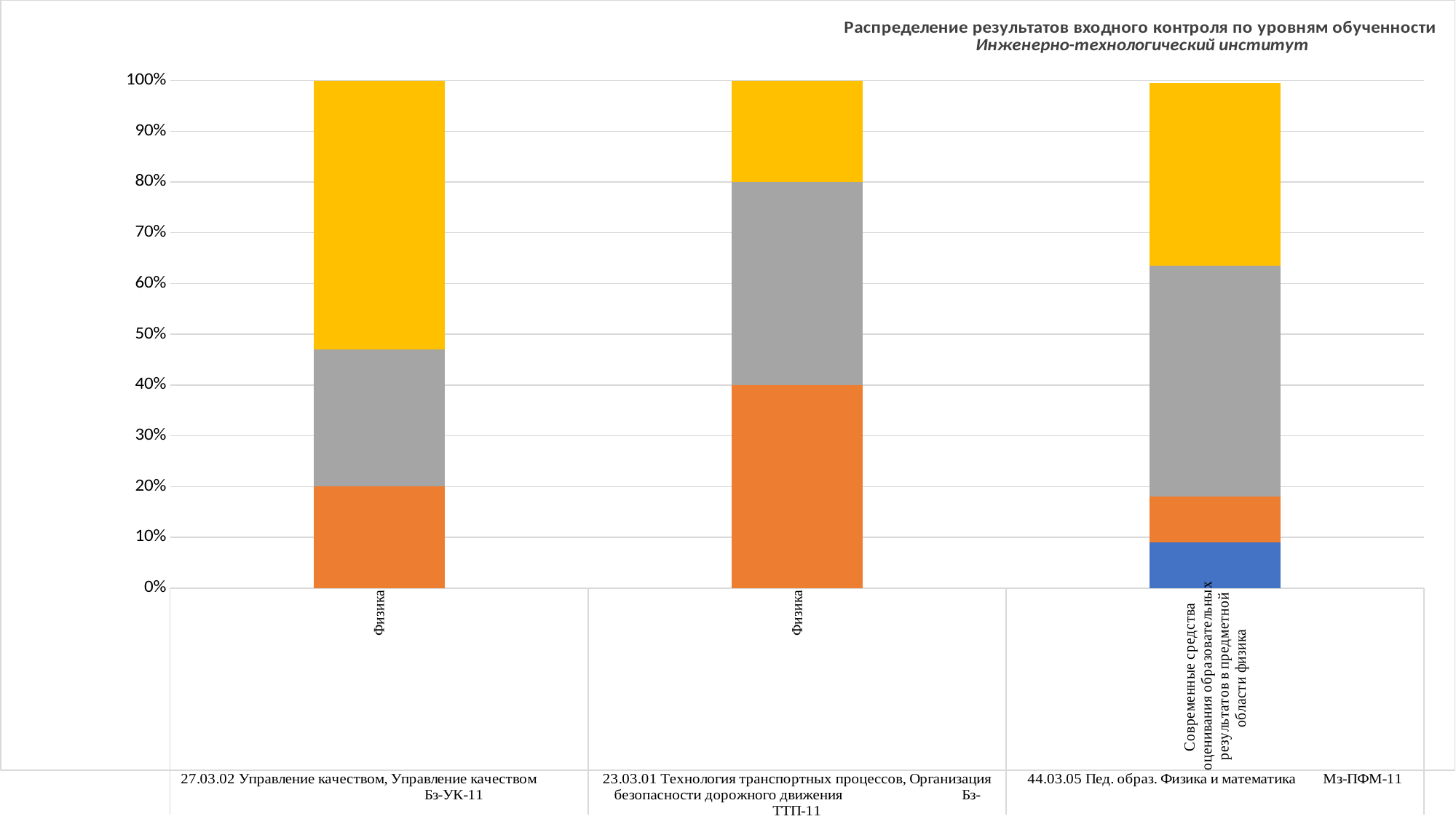
How many bars (groups) are plotted in the chart? 3 What share does the orange segment occupy in the bar for group Бз-УК-11? 20% At what percentage does the top of the gray segment end in the bar for group Бз-ТТП-11? 80% What kind of chart is shown on the slide? Stacked bar chart Is the orange segment larger for group Бз-ТТП-11 or for group Бз-УК-11? Бз-ТТП-11 Which group has the smallest yellow segment? Бз-ТТП-11 Which group has the largest yellow segment? Бз-УК-11 What share does the orange segment occupy in the bar for group Бз-ТТП-11? 40% Is the yellow segment in the bar for group Бз-УК-11 greater or less than 50%? greater Which institute is named in the chart subtitle? Инженерно-технологический институт What is the title of the chart? Распределение результатов входного контроля по уровням обученности